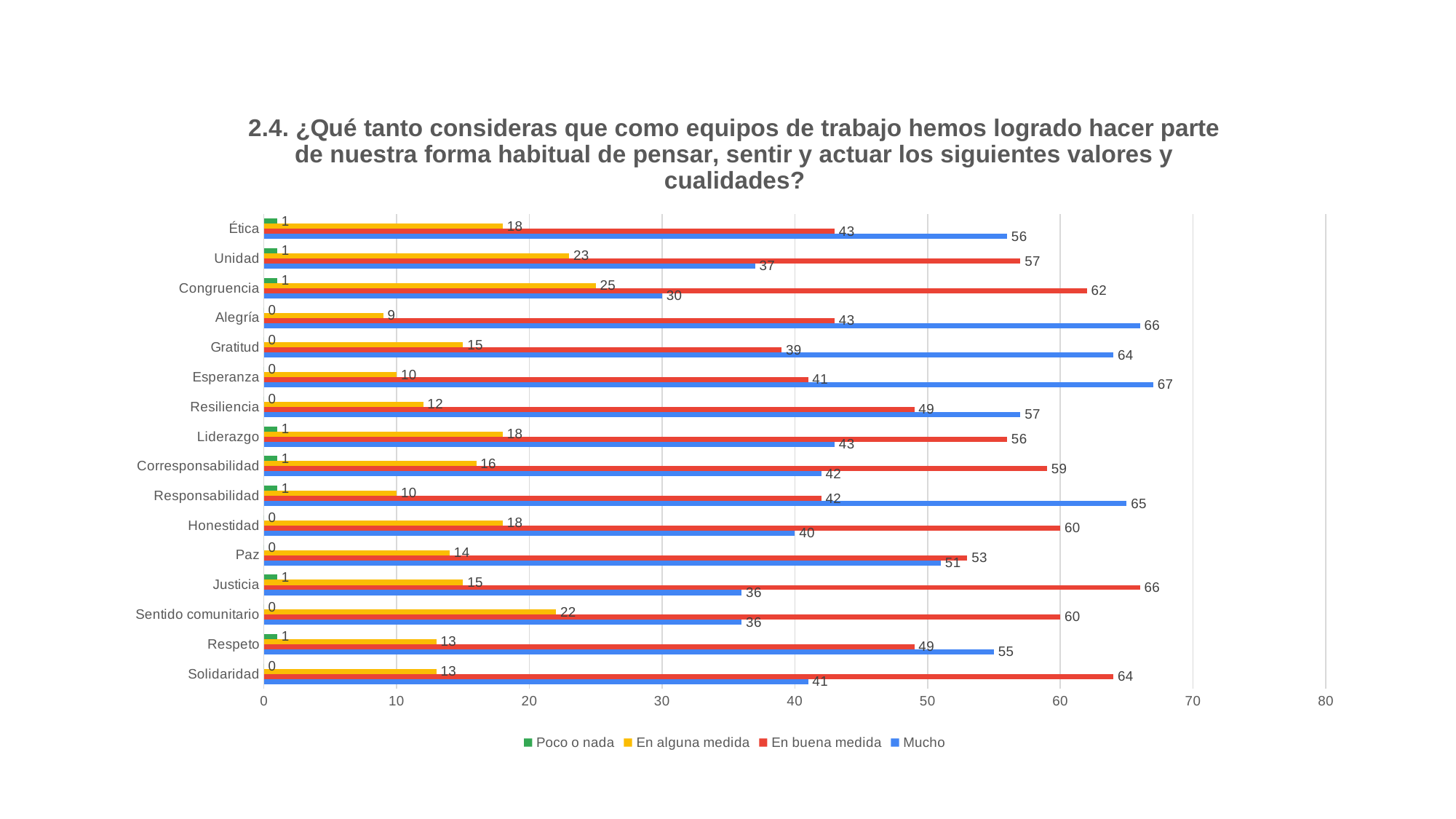
Which category has the highest "En alguna medida" value? Congruencia What is the difference between the "En buena medida" and "Mucho" values for Justicia? 30 For Solidaridad, which is larger: "En buena medida" or "Mucho"? En buena medida What is the value of "Mucho" for Esperanza? 67 Which category has the lowest "Mucho" value? Congruencia What is the value of "En buena medida" for Congruencia? 62 What kind of chart is shown on the slide? Bar chart How many series does the legend list? 4 Which category has the highest "Mucho" value? Esperanza Which colour represents the "Poco o nada" series? Green How many categories are shown on the chart? 16 What is the value of "En alguna medida" for Unidad? 23